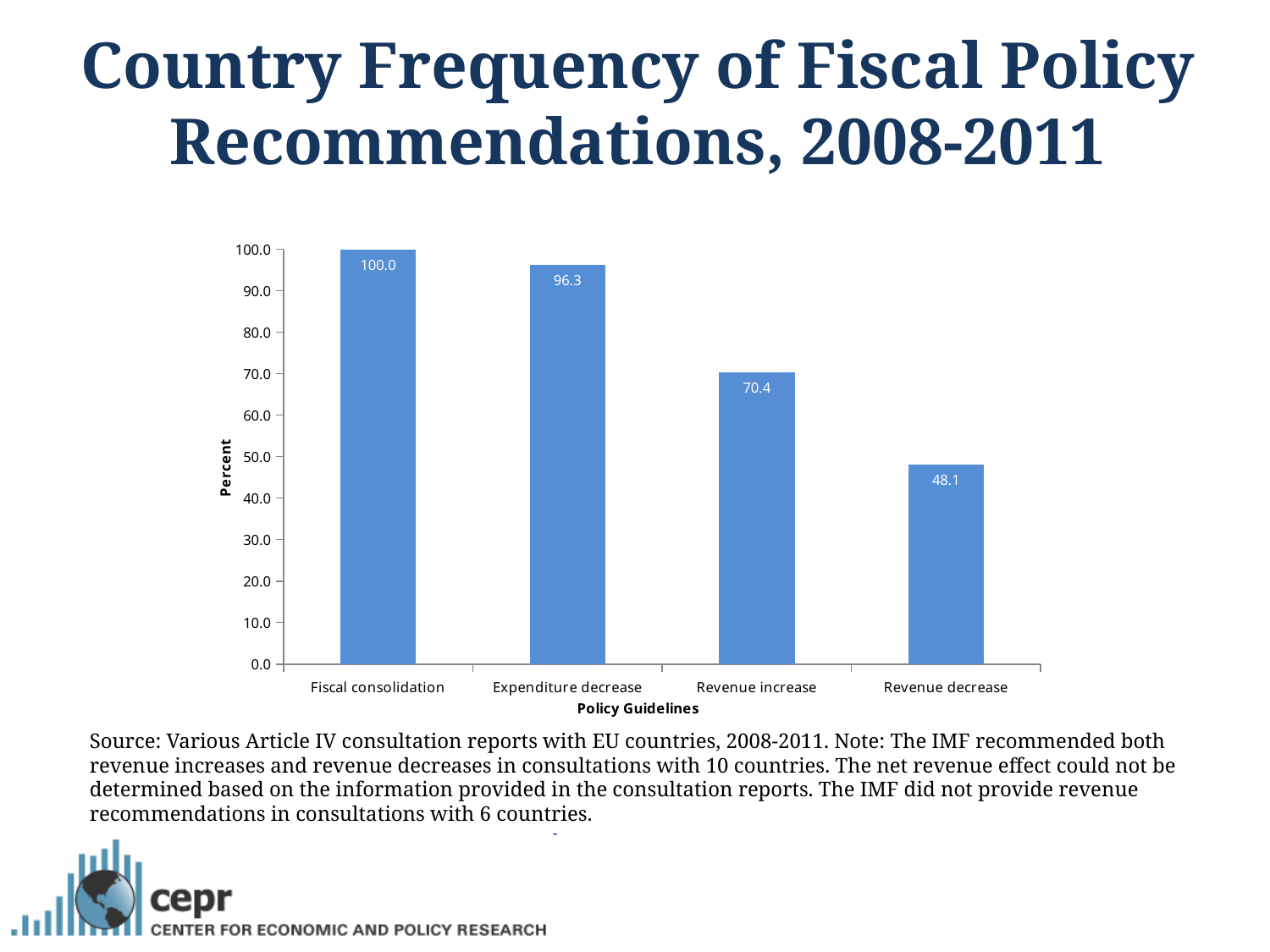
Which policy guideline has the highest value? Fiscal consolidation Which is larger, the value for Expenditure decrease or the value for Revenue increase? Expenditure decrease What is the value for Revenue increase? 70.4 What is the difference between the values for Revenue increase and Revenue decrease? 22.3 What is the value for Revenue decrease? 48.1 Do the values rise or fall from left to right along the x axis? Fall What is the value for Fiscal consolidation? 100.0 How many policy guidelines are shown on the x axis? 4 What is the value for Expenditure decrease? 96.3 Which policy guideline has the lowest value? Revenue decrease What kind of chart is shown on the slide? Bar chart What is the label of the y axis? Percent